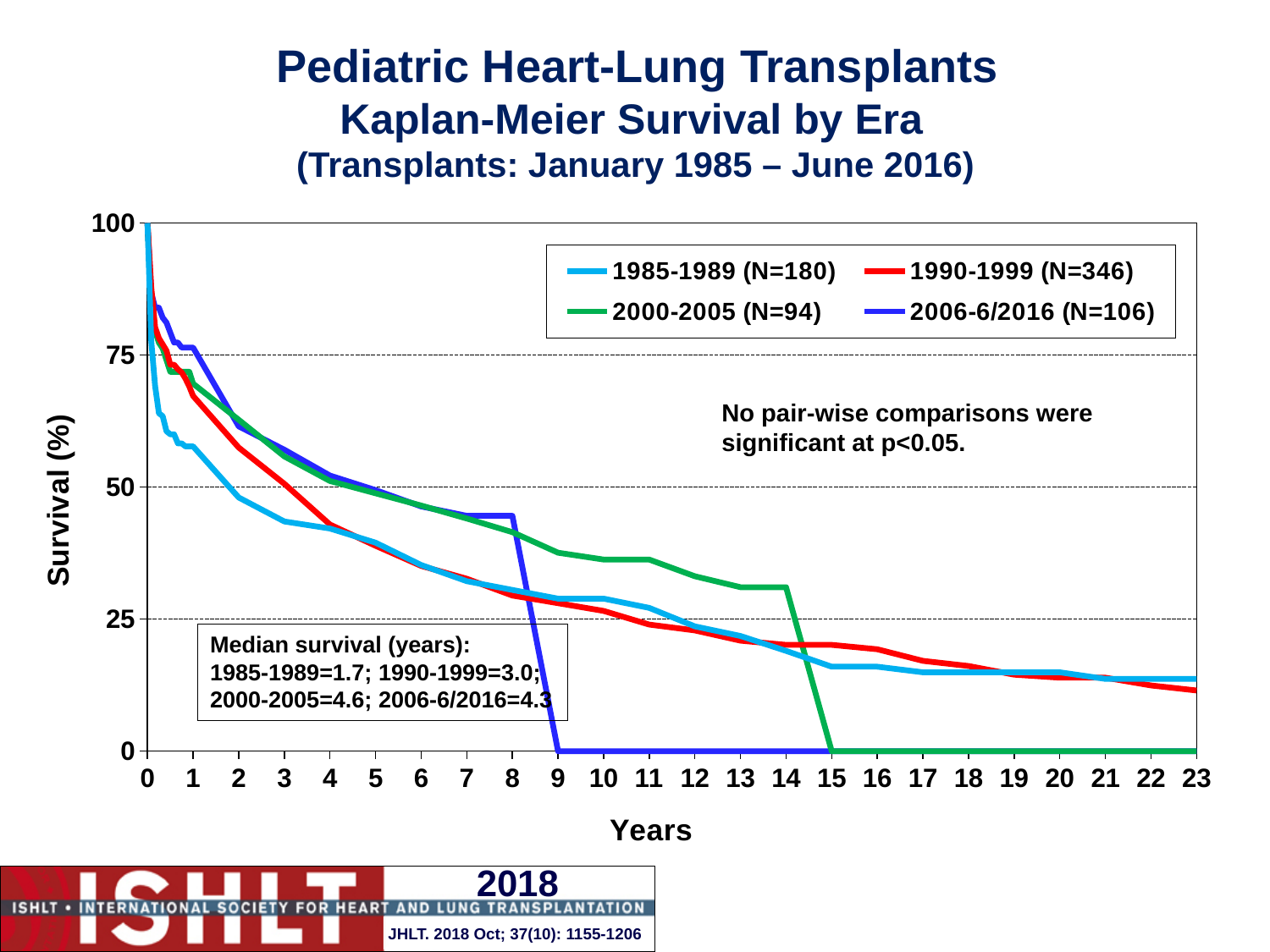
According to the legend, how many transplants (N) are in the 1990-1999 era? 346 Is the survival value for the 1985-1989 era at 5 years greater or less than 50? less What is the label of the y axis? Survival (%) Which era has the longest median survival? 2000-2005 How many series (eras) does the legend list? 4 What kind of chart is shown on the slide? Line chart Which era has the shortest median survival? 1985-1989 Is the survival value for the 2000-2005 era at 10 years greater or less than 25? greater What is the difference in median survival (years) between the 2000-2005 era and the 2006-6/2016 era? 0.3 Do the survival curves rise or fall as years increase? Fall What is the median survival in years for the 1985-1989 era? 1.7 At 14 years, which era has higher survival, 2000-2005 or 1990-1999? 2000-2005